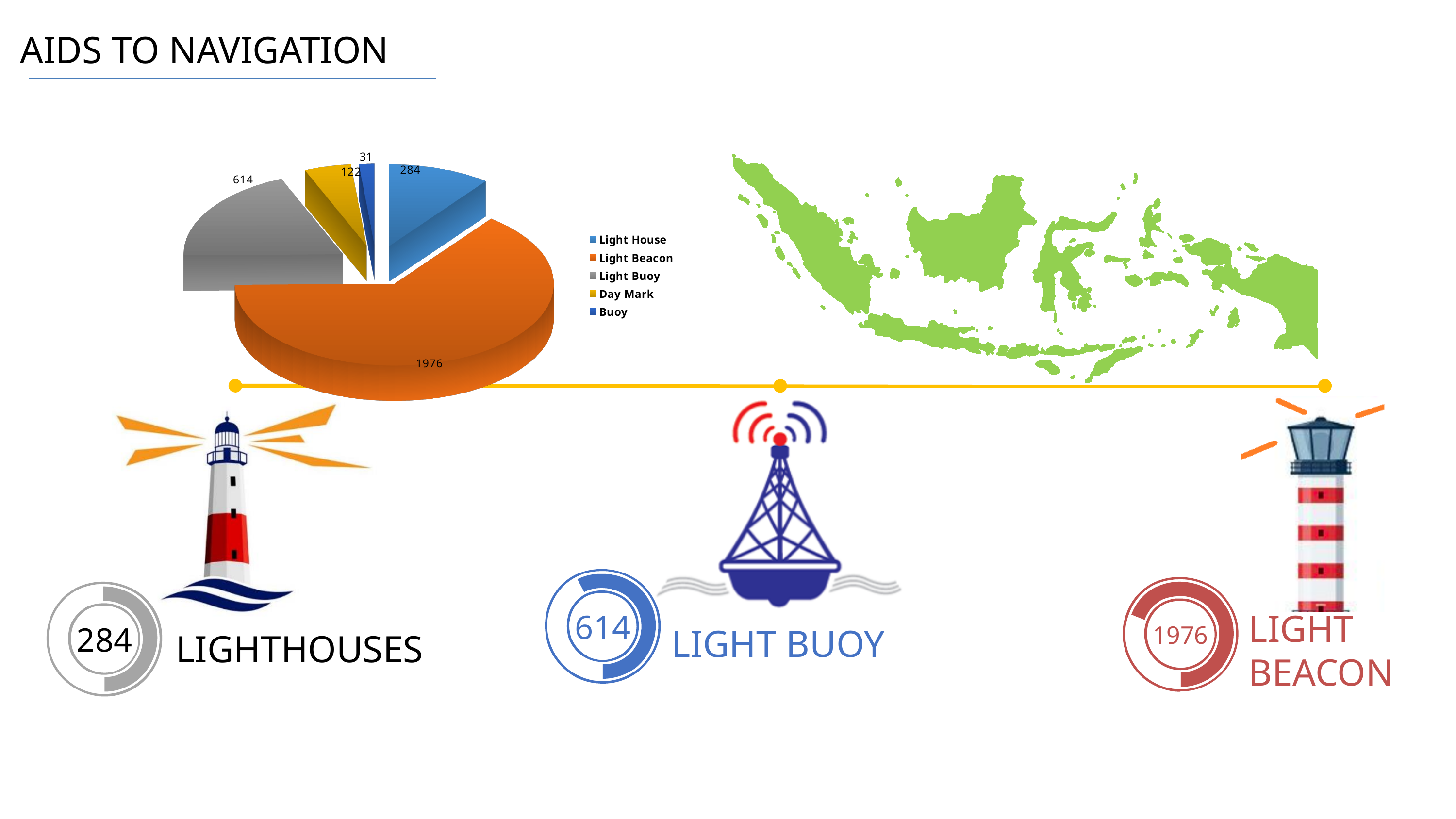
What value is shown for the Buoy slice of the pie chart? 31 What is the difference between the Light Beacon value and the Light Buoy value in the pie chart? 1362 What colour is the Light Beacon slice in the pie chart? Orange What value is shown for the Light Buoy slice of the pie chart? 614 What value is shown for the Light House slice of the pie chart? 284 Which is larger in the pie chart, Light House or Day Mark? Light House What value is shown for the Day Mark slice of the pie chart? 122 Which category has the largest slice in the pie chart? Light Beacon What kind of chart is shown on the slide? Pie chart How many slices does the pie chart have? 5 What value is shown for the Light Beacon slice of the pie chart? 1976 Which category has the smallest slice in the pie chart? Buoy